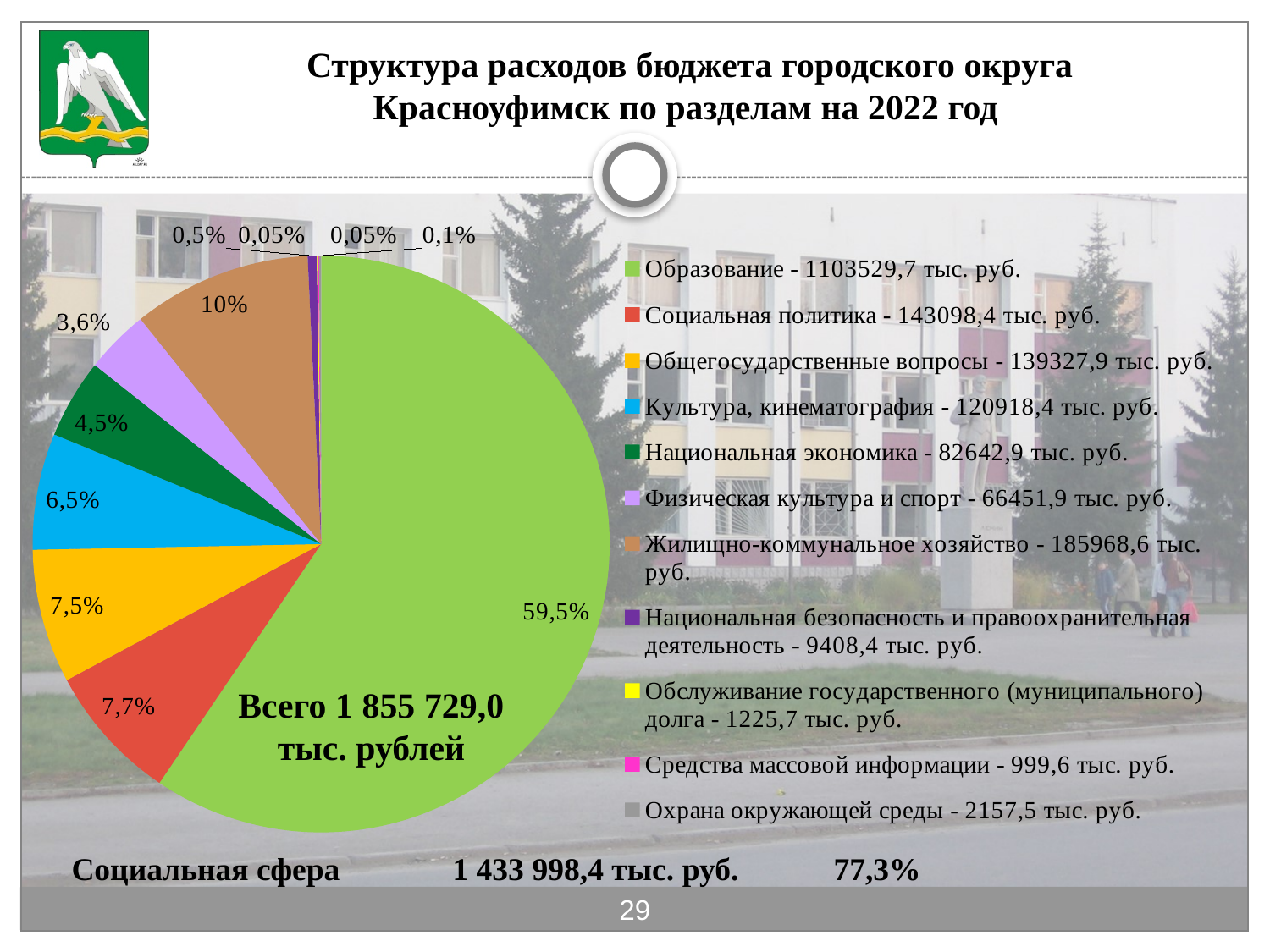
What share of the pie does Образование take? 59,5% How many categories does the legend of the pie chart list? 11 Which category has the largest slice of the pie? Образование Which is larger, the slice for Общегосударственные вопросы or the slice for Физическая культура и спорт? Общегосударственные вопросы What is the value for Национальная экономика according to the legend? 82642,9 тыс. руб. What is the difference in percentage points between the Образование slice and the Жилищно-коммунальное хозяйство slice? 49,5 What share of the pie does Жилищно-коммунальное хозяйство take? 10% What total amount is printed in the centre of the pie chart? Всего 1 855 729,0 тыс. рублей What kind of chart is shown on the slide? pie chart What share of the pie does Социальная политика take? 7,7% What colour is the slice for Образование? green What is the value for Культура, кинематография according to the legend? 120918,4 тыс. руб.